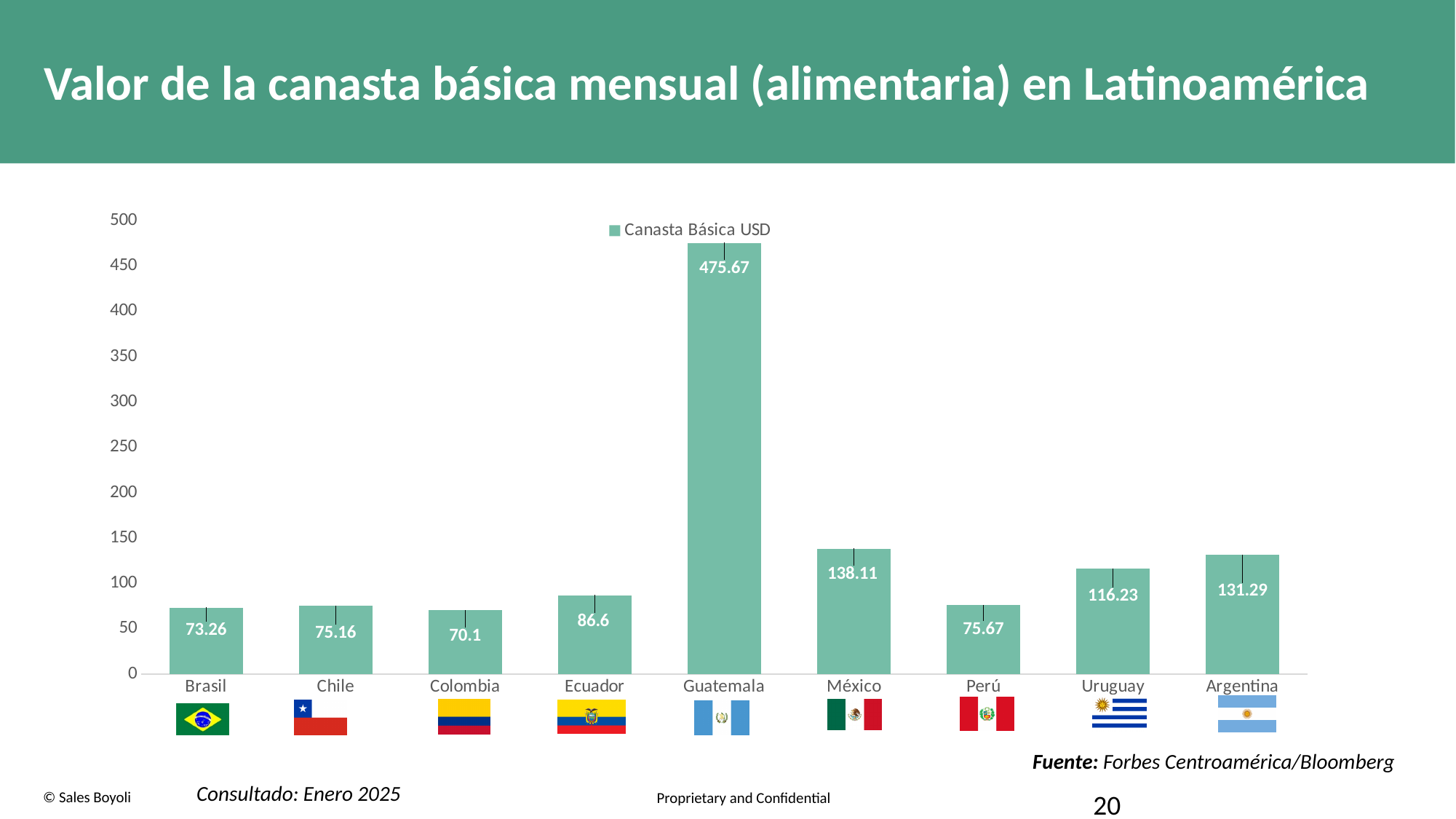
Which country has the lowest value? Colombia What is the difference between the values for Argentina and Uruguay? 15.06 Is the value for Perú greater or less than 100? less Which country has the highest value? Guatemala Which is larger, the value for Ecuador or the value for Chile? Ecuador What is the value for Colombia? 70.1 What is the value for México? 138.11 What kind of chart is shown? bar chart How many countries are shown on the chart? 9 What is the value for Guatemala? 475.67 What is the legend entry for the series? Canasta Básica USD How many series does the legend list? 1